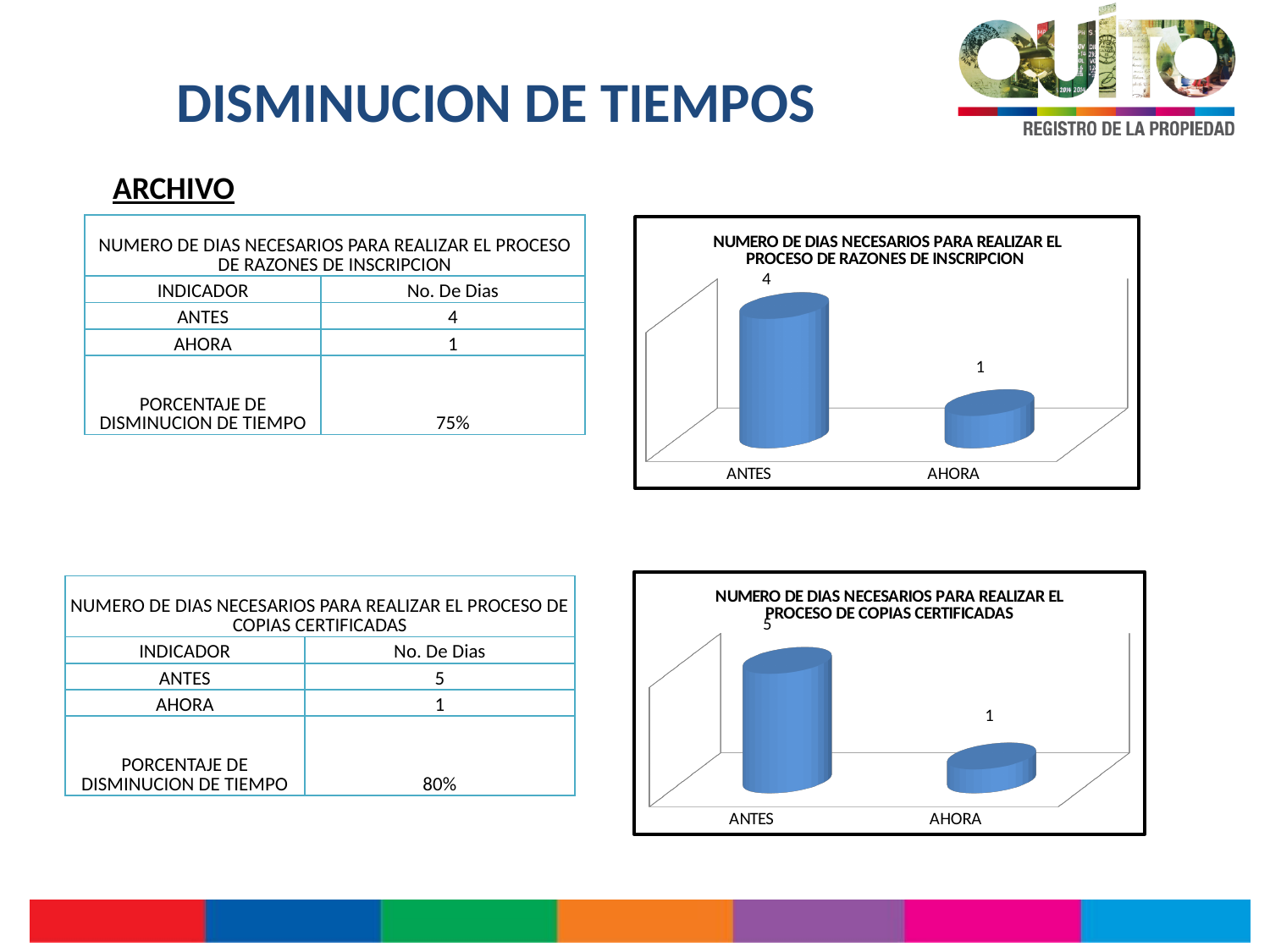
In the bottom chart (COPIAS CERTIFICADAS), what is the value for AHORA? 1 In the bottom chart (COPIAS CERTIFICADAS), what is the difference between the ANTES and AHORA values? 4 In the top chart (RAZONES DE INSCRIPCION), what is the difference between the ANTES and AHORA values? 3 In the top chart (RAZONES DE INSCRIPCION), which category has the highest value? ANTES How many categories are shown in the top chart (RAZONES DE INSCRIPCION)? 2 In the top chart (RAZONES DE INSCRIPCION), what is the value for AHORA? 1 In the bottom chart (COPIAS CERTIFICADAS), what is the value for ANTES? 5 What kind of chart is the bottom chart (COPIAS CERTIFICADAS)? Bar chart In the bottom chart (COPIAS CERTIFICADAS), which is larger, ANTES or AHORA? ANTES What is the title of the top chart? NUMERO DE DIAS NECESARIOS PARA REALIZAR EL PROCESO DE RAZONES DE INSCRIPCION In the bottom chart (COPIAS CERTIFICADAS), which category has the lowest value? AHORA In the top chart (RAZONES DE INSCRIPCION), what is the value for ANTES? 4